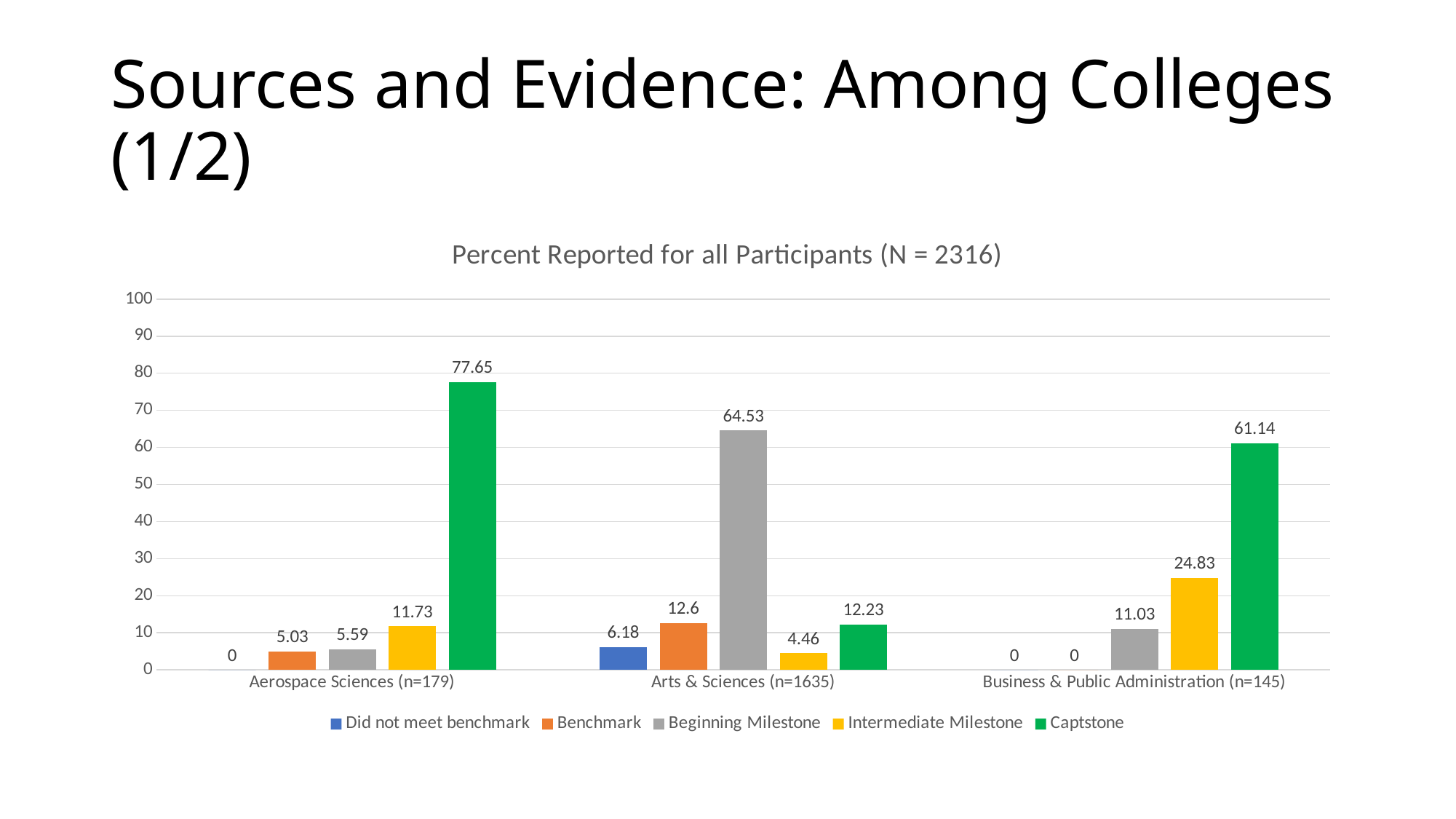
What type of chart is shown on the slide? bar chart What is the Did not meet benchmark value for Arts & Sciences (n=1635)? 6.18 Which college has the lowest Beginning Milestone value? Aerospace Sciences (n=179) What is the difference between the Captstone values for Aerospace Sciences (n=179) and Business & Public Administration (n=145)? 16.51 Which college has the highest Captstone value? Aerospace Sciences (n=179) What is the Intermediate Milestone value for Business & Public Administration (n=145)? 24.83 What is the Captstone value for Aerospace Sciences (n=179)? 77.65 What is the Beginning Milestone value for Arts & Sciences (n=1635)? 64.53 How many colleges are shown on the x axis? 3 How many series does the legend list? 5 Is the Beginning Milestone value for Arts & Sciences (n=1635) greater or less than 60? greater Which is larger: the Benchmark value for Arts & Sciences (n=1635) or the Benchmark value for Aerospace Sciences (n=179)? Arts & Sciences (n=1635)